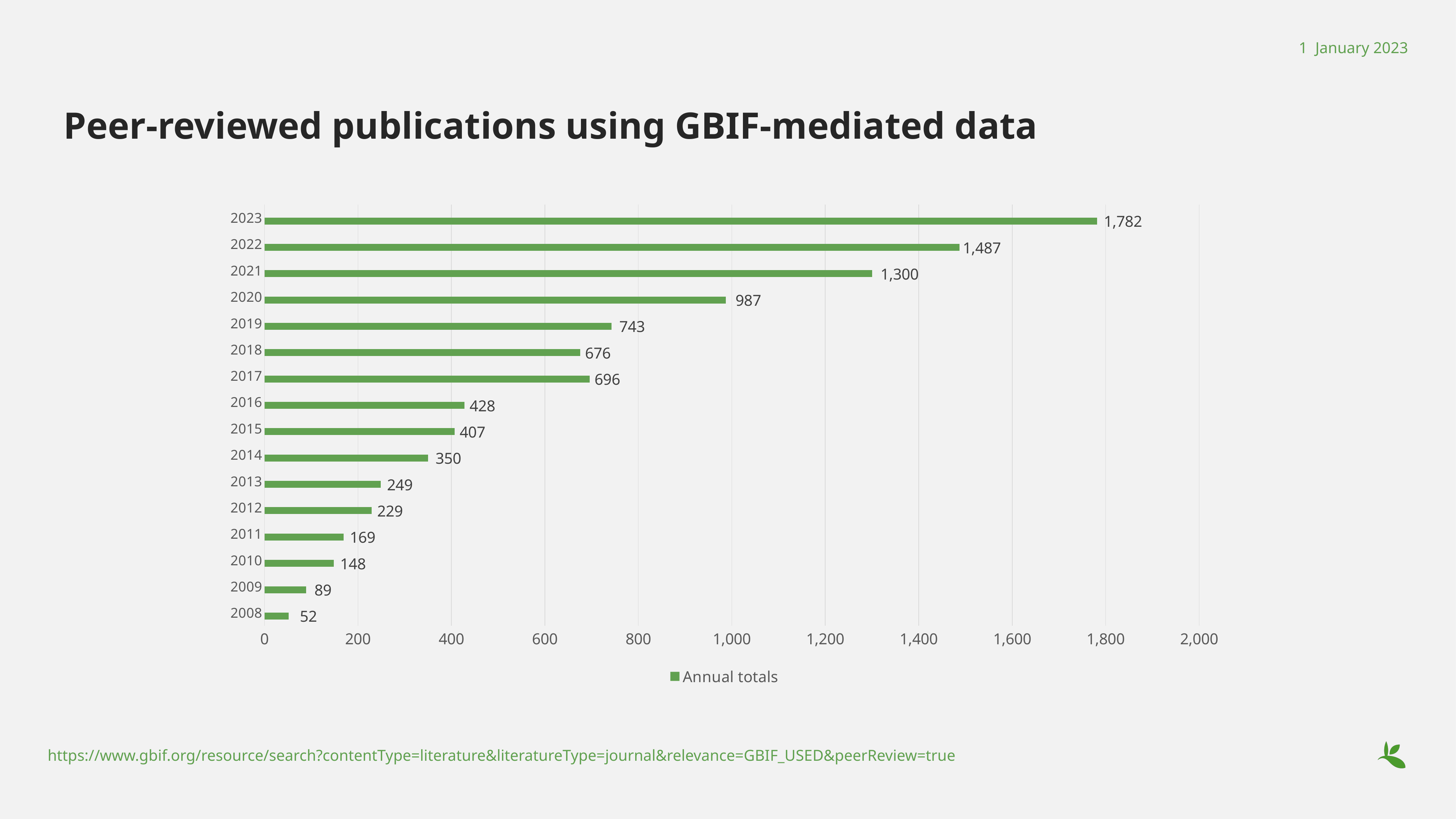
What is the value for 2008? 52 What is the difference between the values for 2017 and 2018? 20 Is the value for 2020 greater or less than 1,000? less What kind of chart is shown on the slide? bar chart What is the name of the series listed in the legend? Annual totals Which is larger, the value for 2017 or the value for 2018? 2017 What is the value for 2023? 1,782 How many years are shown in the chart? 16 What is the difference between the values for 2023 and 2022? 295 Which year has the lowest value? 2008 What is the value for 2017? 696 Which year has the highest value? 2023